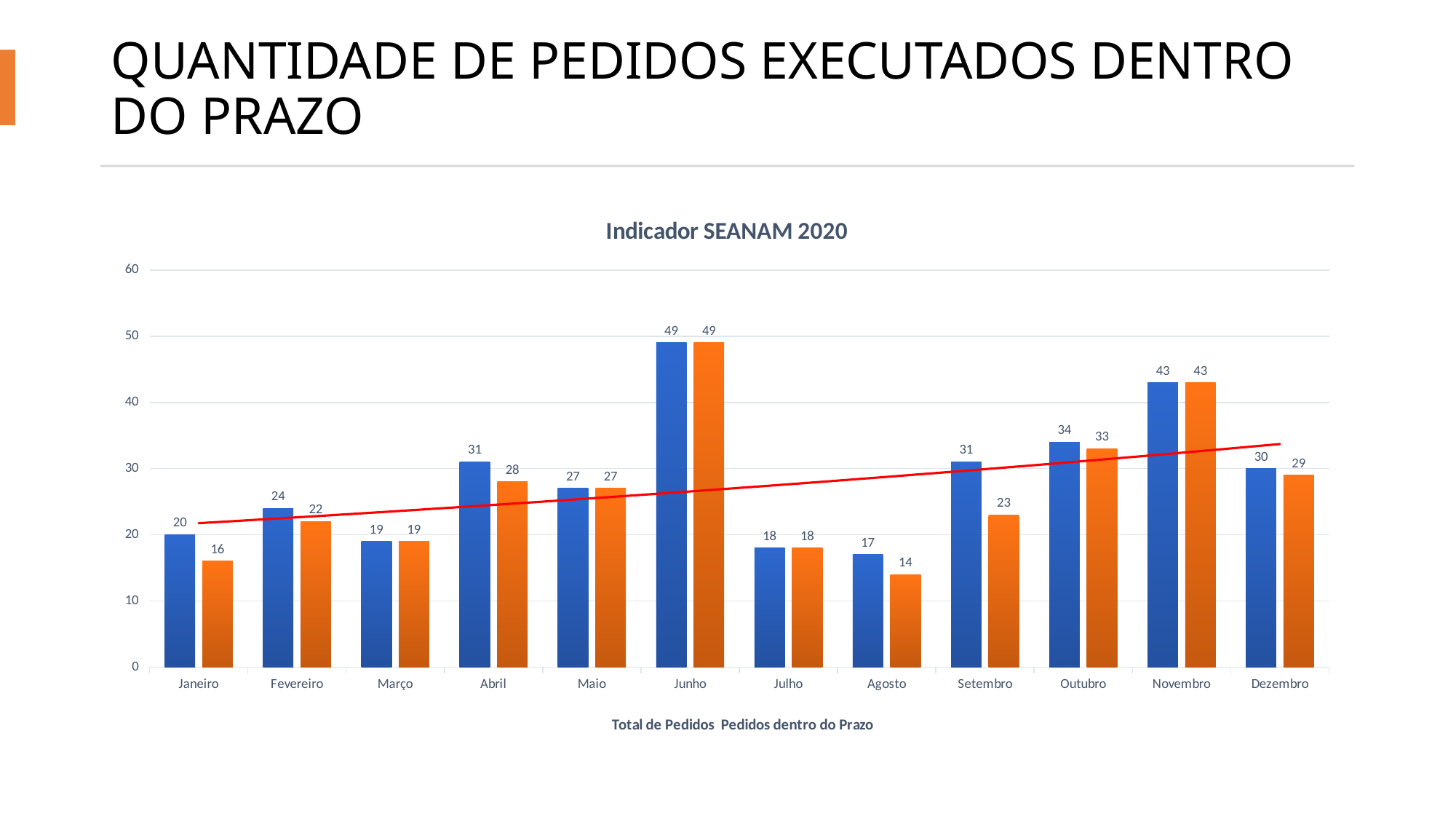
Which month has the lowest value for Pedidos dentro do Prazo? Agosto Which month has the highest value for Total de Pedidos? Junho Is the value of Total de Pedidos for Novembro greater or less than 40? greater What is the value of Pedidos dentro do Prazo for Setembro? 23 How many series does the legend list? 2 What is the difference between Total de Pedidos and Pedidos dentro do Prazo in Setembro? 8 What kind of chart is shown on the slide? Bar chart What is the title of the chart? Indicador SEANAM 2020 What is the value of Pedidos dentro do Prazo for Janeiro? 16 Which is larger: Total de Pedidos in Outubro or Total de Pedidos in Dezembro? Outubro What is the value of Total de Pedidos for Junho? 49 How many months are shown on the x axis? 12